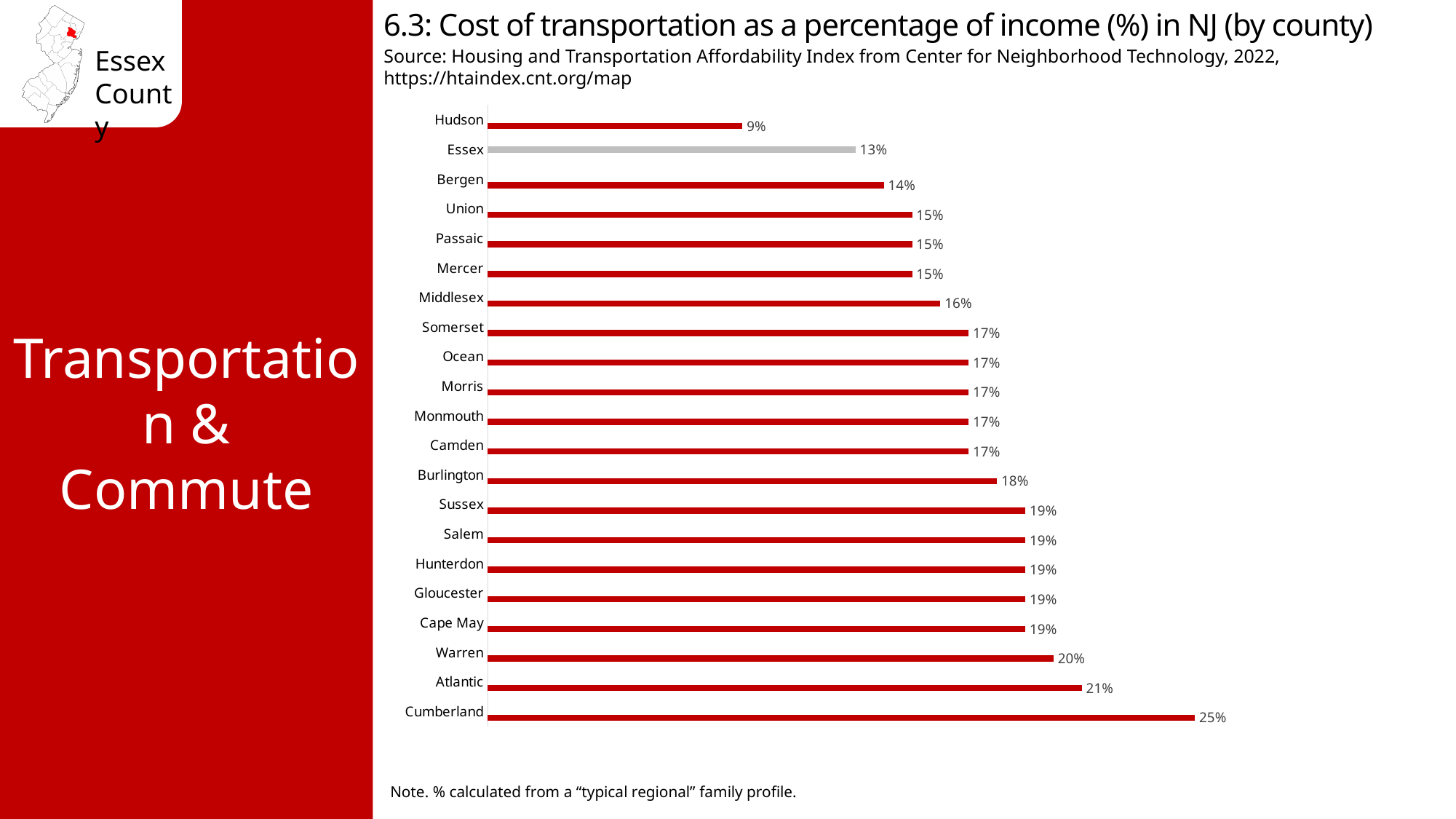
What is the difference between the values for Cumberland and Essex? 12% Which county has the lowest cost of transportation as a percentage of income? Hudson Which county has the highest cost of transportation as a percentage of income? Cumberland What is the value shown for Burlington County? 18% How many counties are shown in the chart? 21 What is the value shown for Hudson County? 9% Which has a higher value, Bergen or Warren? Warren What is the difference between the values for Atlantic and Hudson? 12% Which county's bar is shown in grey rather than red? Essex What is the cost of transportation as a percentage of income for Cumberland County? 25% What kind of chart is shown on the slide? Bar chart What is the cost of transportation as a percentage of income for Essex County? 13%